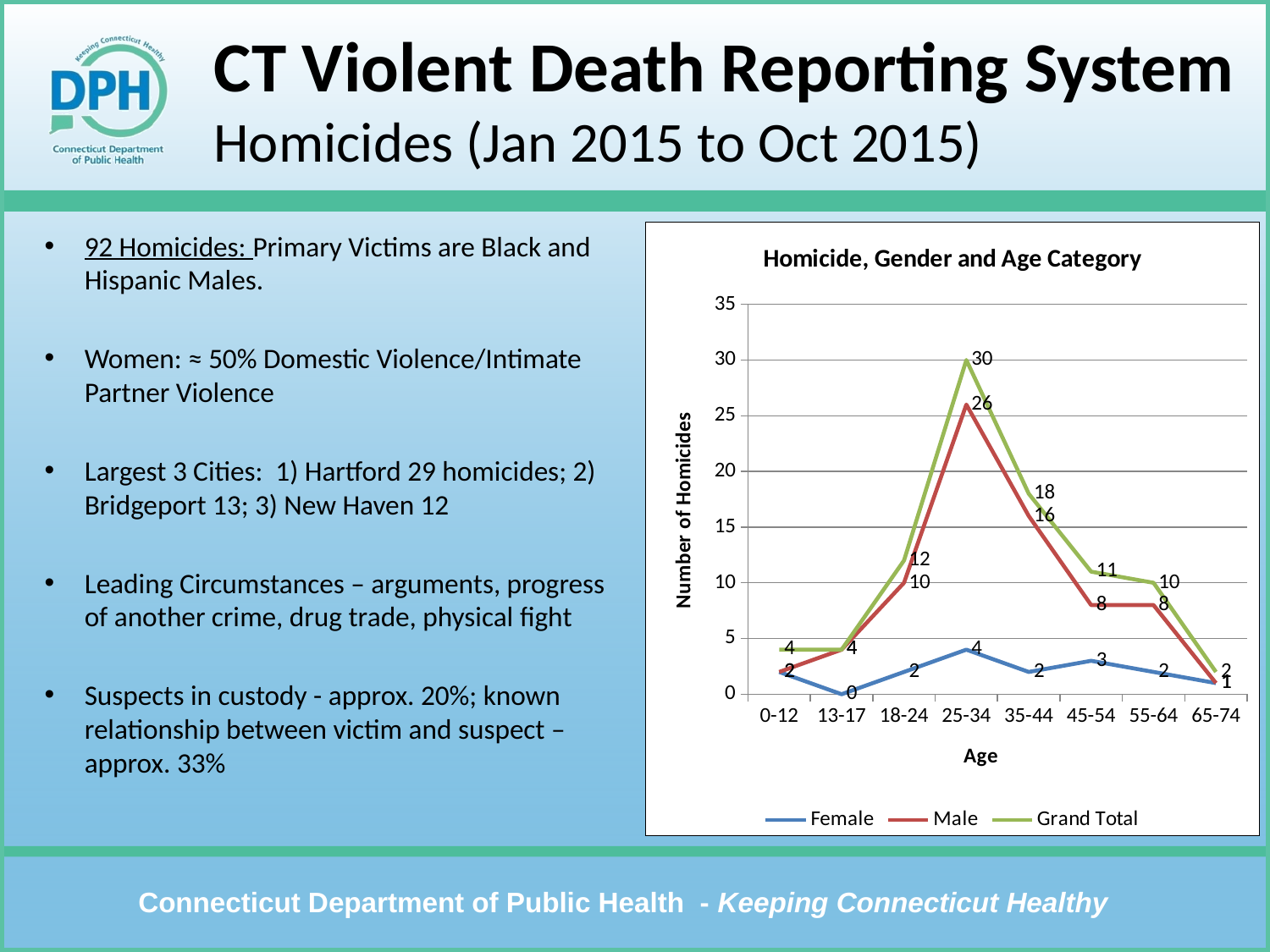
What is the difference between the Grand Total for 25-34 and the Grand Total for 35-44? 12 Which age category has the highest Grand Total? 25-34 What is the Male value for the 35-44 age category? 16 What is the Male value for the 25-34 age category? 26 How many series does the chart legend list? 3 What kind of chart is shown on the slide? Line chart What is the Grand Total value for the 25-34 age category? 30 How many age categories are shown on the x axis of the chart? 8 What is the title of the chart? Homicide, Gender and Age Category Which is larger, the Male value for 18-24 or the Male value for 45-54? 18-24 What is the Female value for the 13-17 age category? 0 Does the Grand Total line rise or fall from the 25-34 category to the 65-74 category? Fall